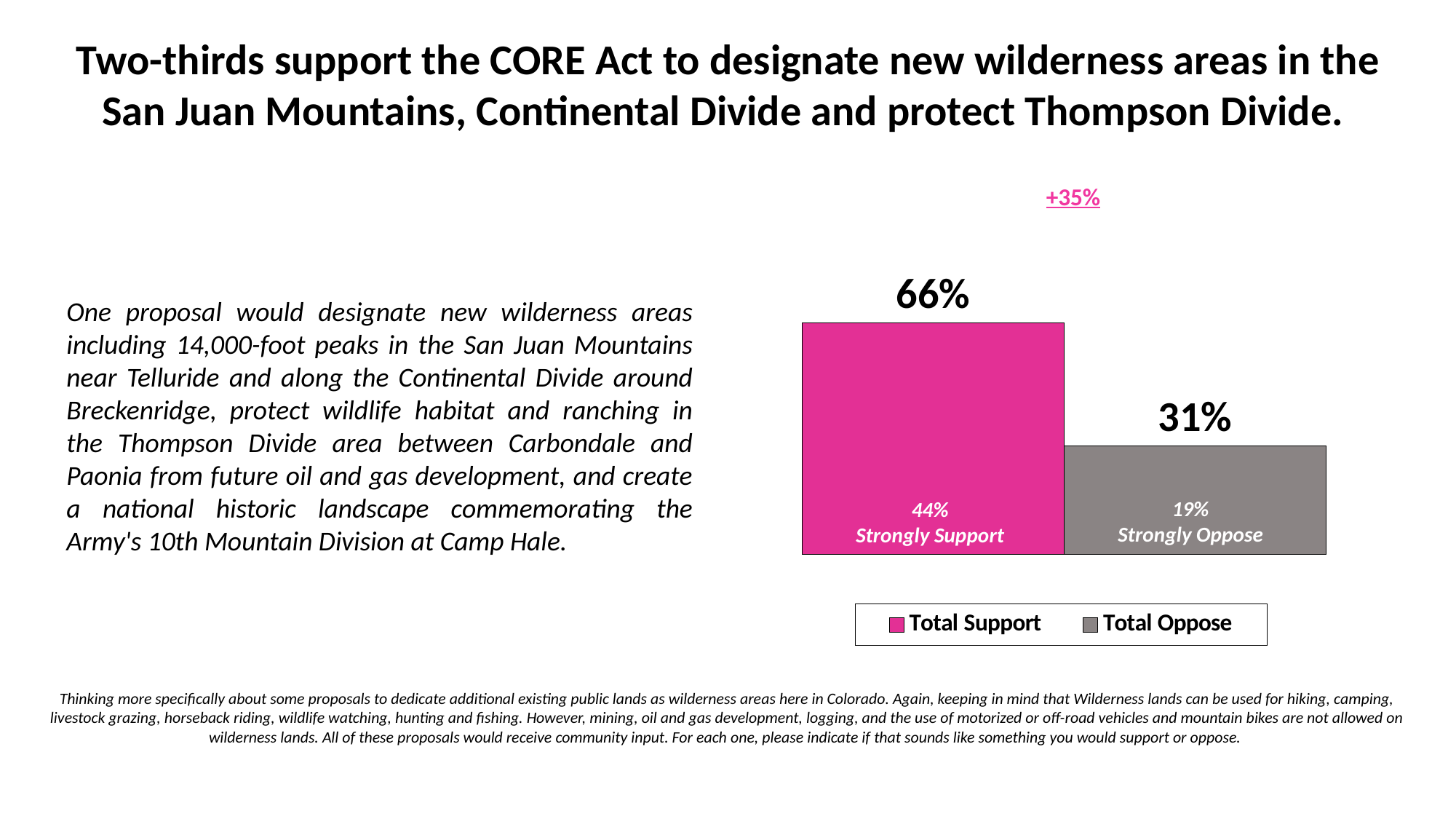
What kind of chart is shown on the slide? Bar chart What is the difference between Total Support and Total Oppose? 35% What percentage Strongly Support the proposal? 44% What percentage Strongly Oppose the proposal? 19% Which series has the higher value, Total Support or Total Oppose? Total Support What is the value for Total Support? 66% What is the value for Total Oppose? 31% How many series does the legend list? 2 Which series has the lowest value? Total Oppose What is the difference between Strongly Support and Strongly Oppose? 25% What colour is the Total Support bar? Pink What net difference is annotated above the chart? +35%